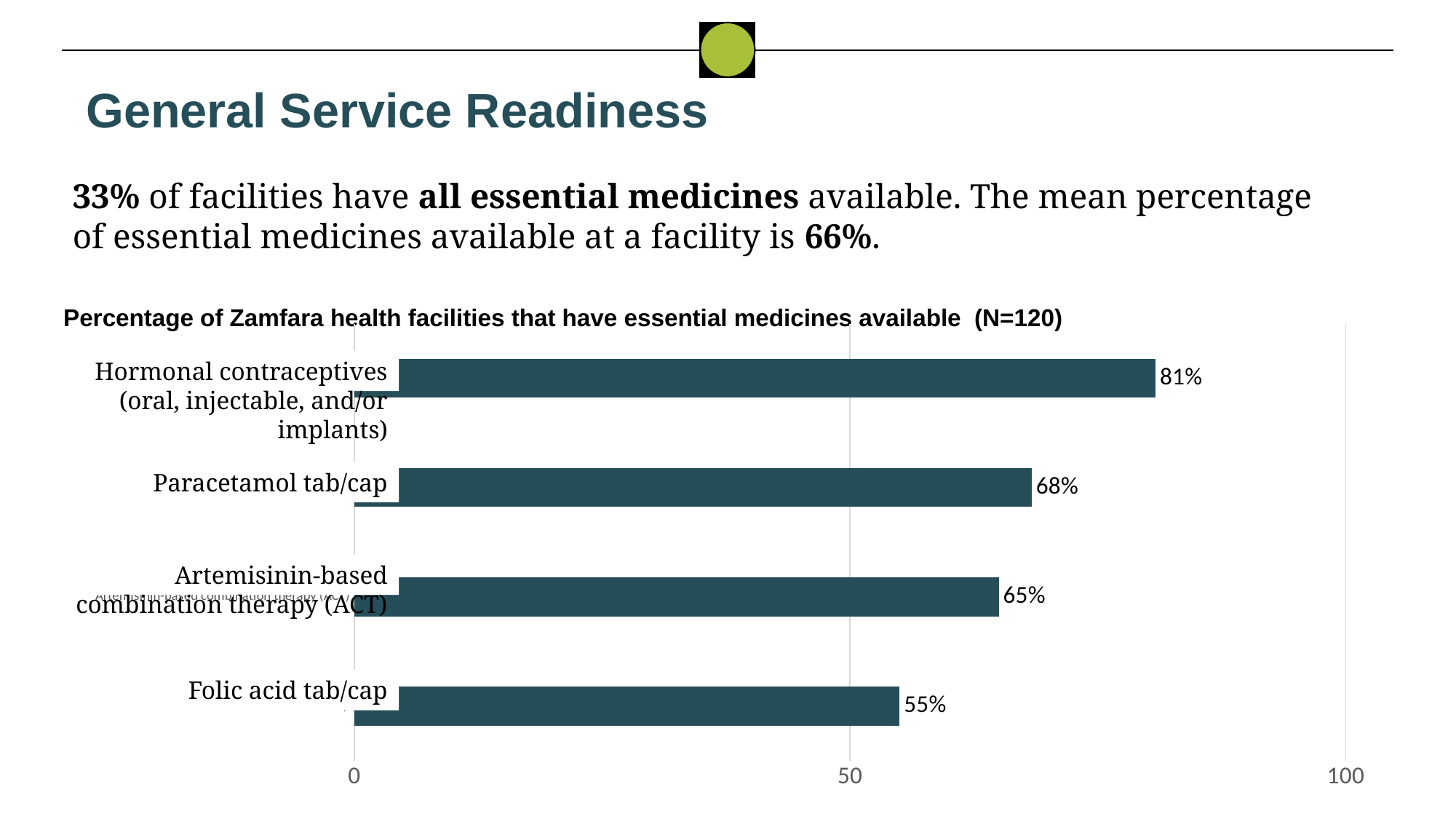
What kind of chart is shown on the slide? Bar chart Which essential medicine is available at the highest percentage of facilities? Hormonal contraceptives (oral, injectable, and/or implants) How many essential medicines are shown in the chart? 4 Is the value for Folic acid tab/cap greater or less than 50? greater Which essential medicine is available at the lowest percentage of facilities? Folic acid tab/cap What percentage of facilities have Folic acid tab/cap available? 55% What is the difference in percentage points between hormonal contraceptives and Folic acid tab/cap? 26 What is the sample size (N) stated in the chart title? 120 What percentage of facilities have Paracetamol tab/cap available? 68% What is the value shown for Artemisinin-based combination therapy (ACT)? 65% Which has a higher availability percentage, Paracetamol tab/cap or Folic acid tab/cap? Paracetamol tab/cap What percentage of Zamfara health facilities have hormonal contraceptives available? 81%